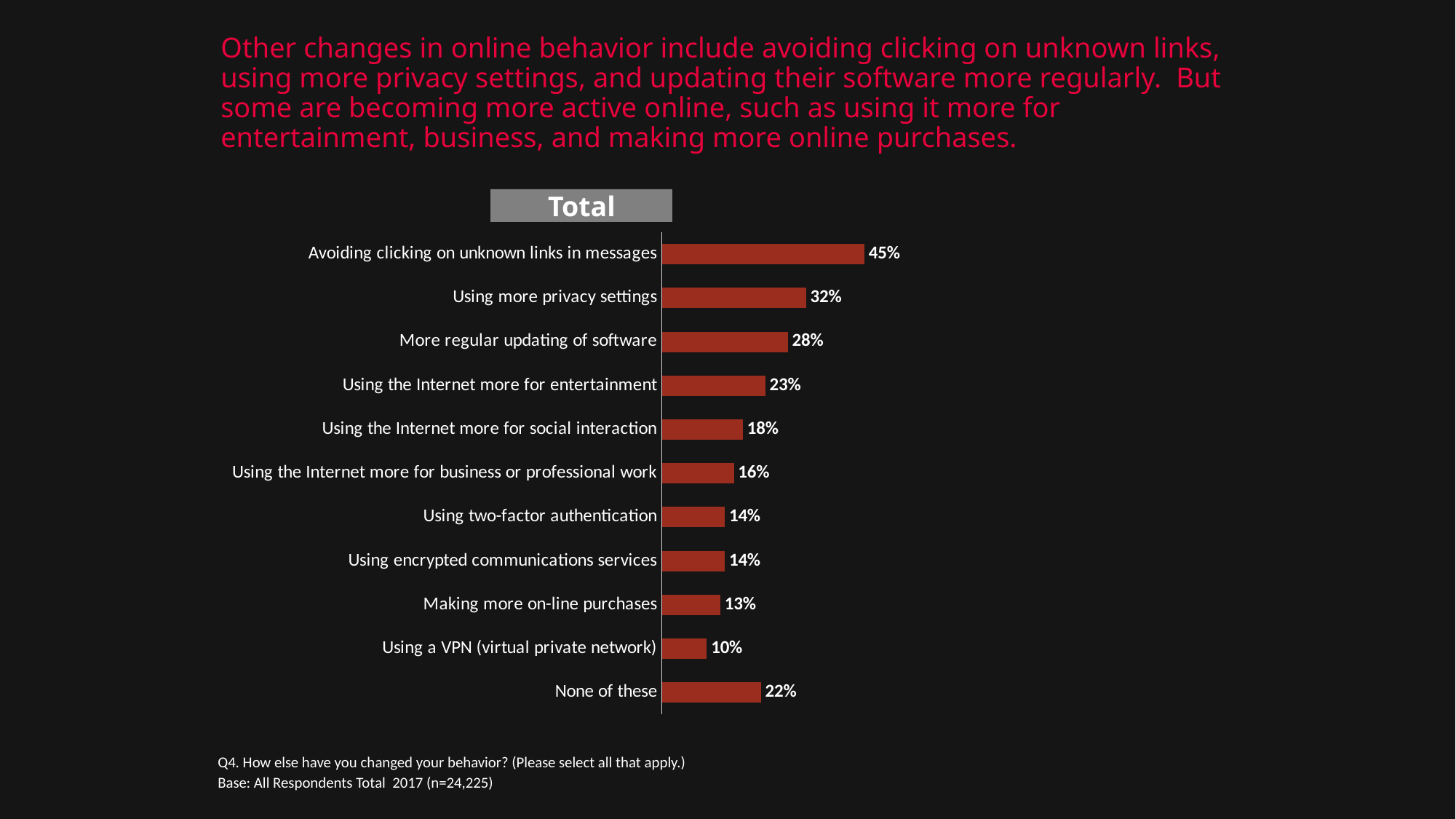
How many categories are shown in the chart? 11 Which category has the highest value in the chart? Avoiding clicking on unknown links in messages What is the value for 'Making more on-line purchases'? 13% What is the difference between 'Using more privacy settings' and 'More regular updating of software'? 4% What is the value for 'Using a VPN (virtual private network)'? 10% What is the header label shown above the chart? Total What is the difference between 'Avoiding clicking on unknown links in messages' and 'None of these'? 23% Which is larger: 'Using the Internet more for entertainment' or 'Using the Internet more for social interaction'? Using the Internet more for entertainment What percentage selected 'None of these'? 22% Which category has the lowest value in the chart? Using a VPN (virtual private network) What type of chart is shown on the slide? Bar chart What percentage of respondents reported avoiding clicking on unknown links in messages? 45%